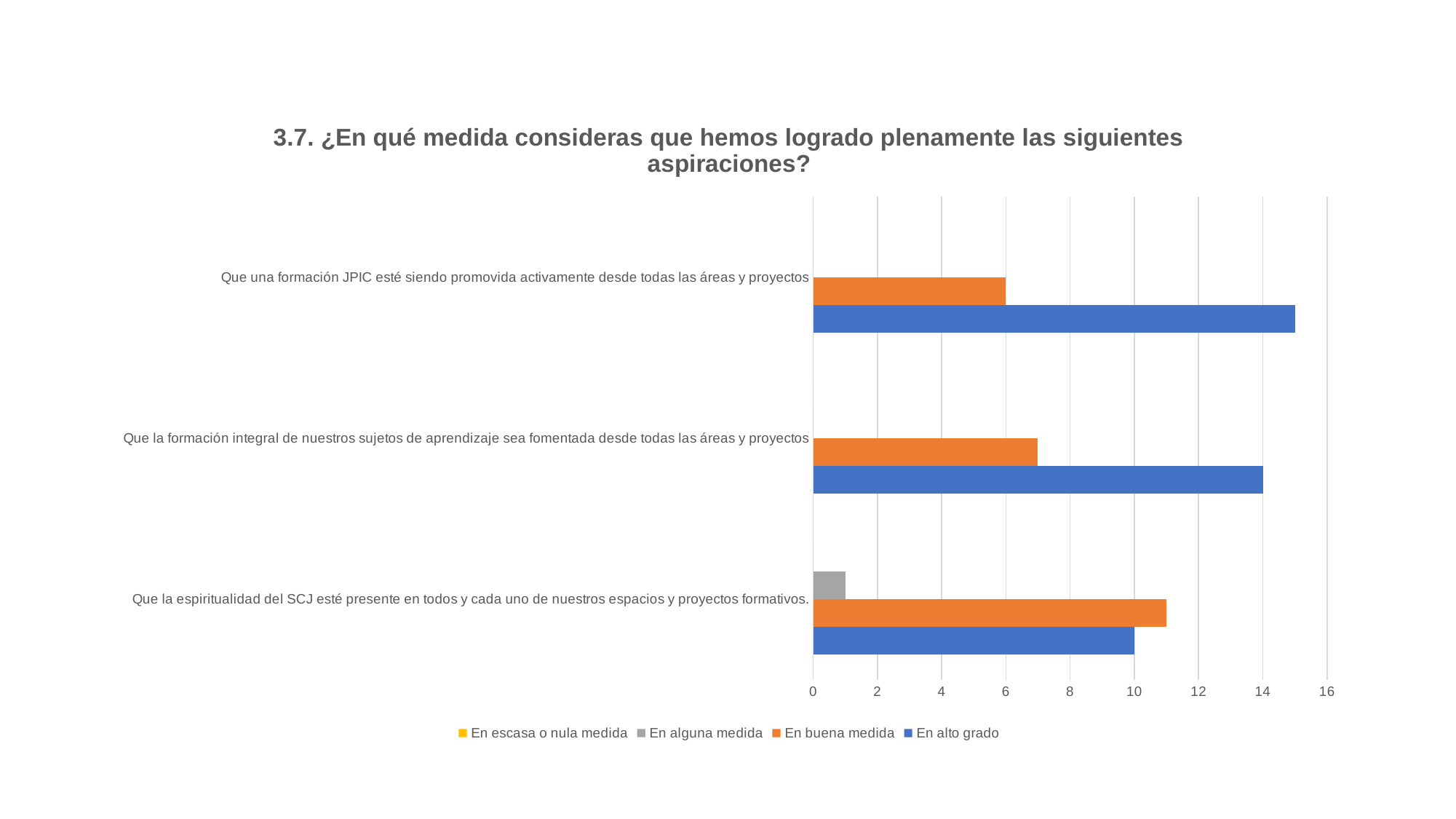
How many series does the legend list? 4 How many categories (aspirations) are shown on the chart? 3 What is the value of 'En alto grado' for 'Que la espiritualidad del SCJ esté presente en todos y cada uno de nuestros espacios y proyectos formativos.'? 10 Which category has the highest 'En alto grado' value? Que una formación JPIC esté siendo promovida activamente desde todas las áreas y proyectos Is the 'En alto grado' value for 'Que una formación JPIC esté siendo promovida activamente desde todas las áreas y proyectos' greater or less than 14? greater Is the 'En buena medida' value for 'Que la espiritualidad del SCJ esté presente en todos y cada uno de nuestros espacios y proyectos formativos.' greater or less than 10? greater Is the 'En alguna medida' value for 'Que la espiritualidad del SCJ esté presente en todos y cada uno de nuestros espacios y proyectos formativos.' greater or less than 2? less What is the value of 'En buena medida' for 'Que una formación JPIC esté siendo promovida activamente desde todas las áreas y proyectos'? 6 What kind of chart is shown on the slide? bar chart Which category has the highest 'En buena medida' value? Que la espiritualidad del SCJ esté presente en todos y cada uno de nuestros espacios y proyectos formativos. What is the value of 'En alto grado' for 'Que la formación integral de nuestros sujetos de aprendizaje sea fomentada desde todas las áreas y proyectos'? 14 For 'Que la formación integral de nuestros sujetos de aprendizaje sea fomentada desde todas las áreas y proyectos', which is larger: 'En alto grado' or 'En buena medida'? En alto grado